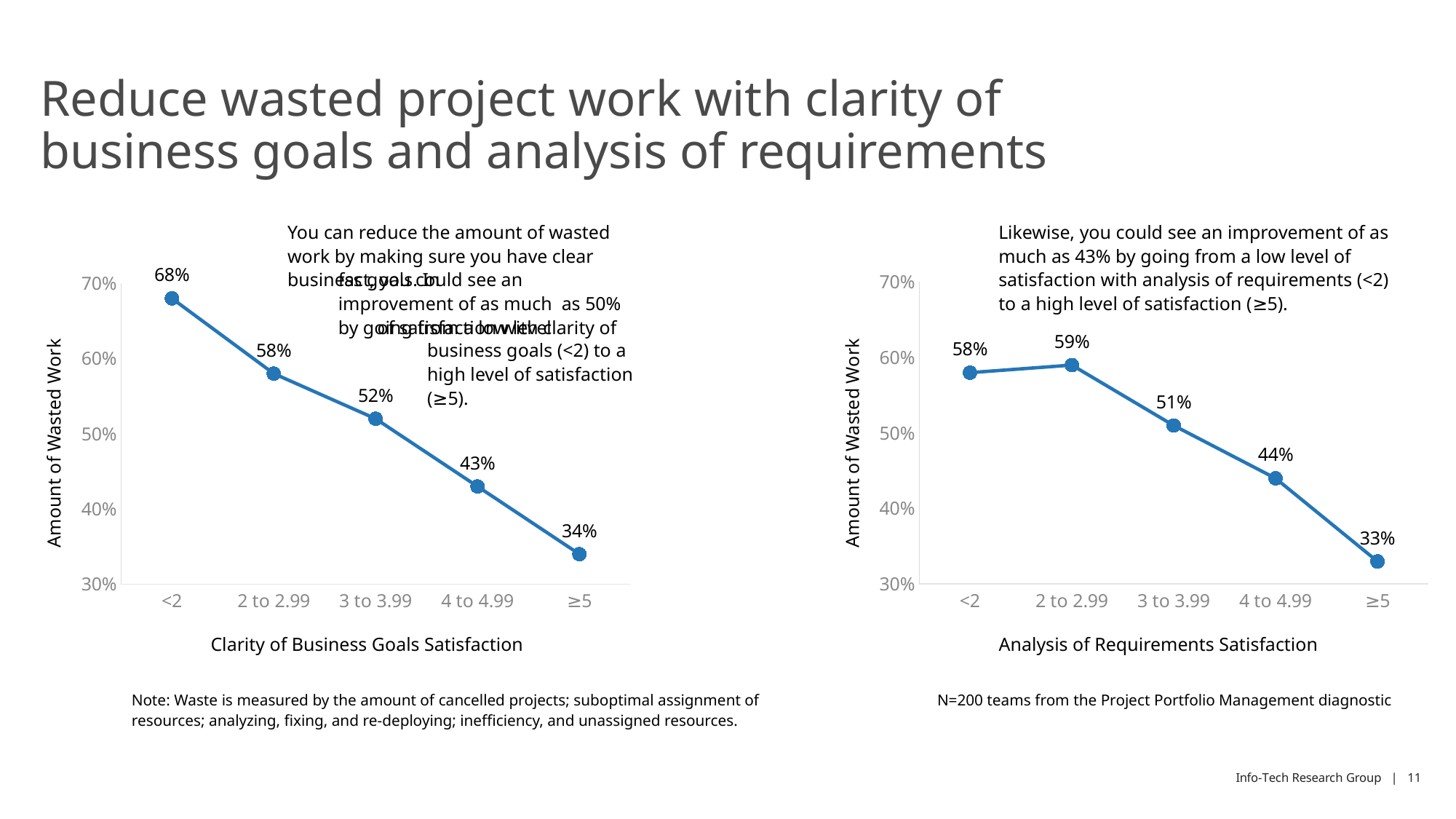
In the left chart (Clarity of Business Goals Satisfaction), what is the difference in wasted work between the <2 and ≥5 categories? 34% In the left chart (Clarity of Business Goals Satisfaction), does the amount of wasted work rise or fall as satisfaction increases along the x axis? Fall How many categories are shown on the x axis of the right chart (Analysis of Requirements Satisfaction)? 5 In the left chart (Clarity of Business Goals Satisfaction), which category has the lowest amount of wasted work? ≥5 In the left chart (Clarity of Business Goals Satisfaction), what is the amount of wasted work for the 3 to 3.99 category? 52% In the right chart (Analysis of Requirements Satisfaction), which category has the highest amount of wasted work? 2 to 2.99 In the right chart (Analysis of Requirements Satisfaction), what is the amount of wasted work for the 2 to 2.99 category? 59% What kind of chart is the left chart (Clarity of Business Goals Satisfaction)? Line chart In the right chart (Analysis of Requirements Satisfaction), what is the amount of wasted work for the ≥5 category? 33% In the left chart (Clarity of Business Goals Satisfaction), what is the amount of wasted work for the <2 category? 68% In the right chart (Analysis of Requirements Satisfaction), what is the difference in wasted work between the 3 to 3.99 and 4 to 4.99 categories? 7% In the left chart (Clarity of Business Goals Satisfaction), which has a higher amount of wasted work: 2 to 2.99 or 4 to 4.99? 2 to 2.99